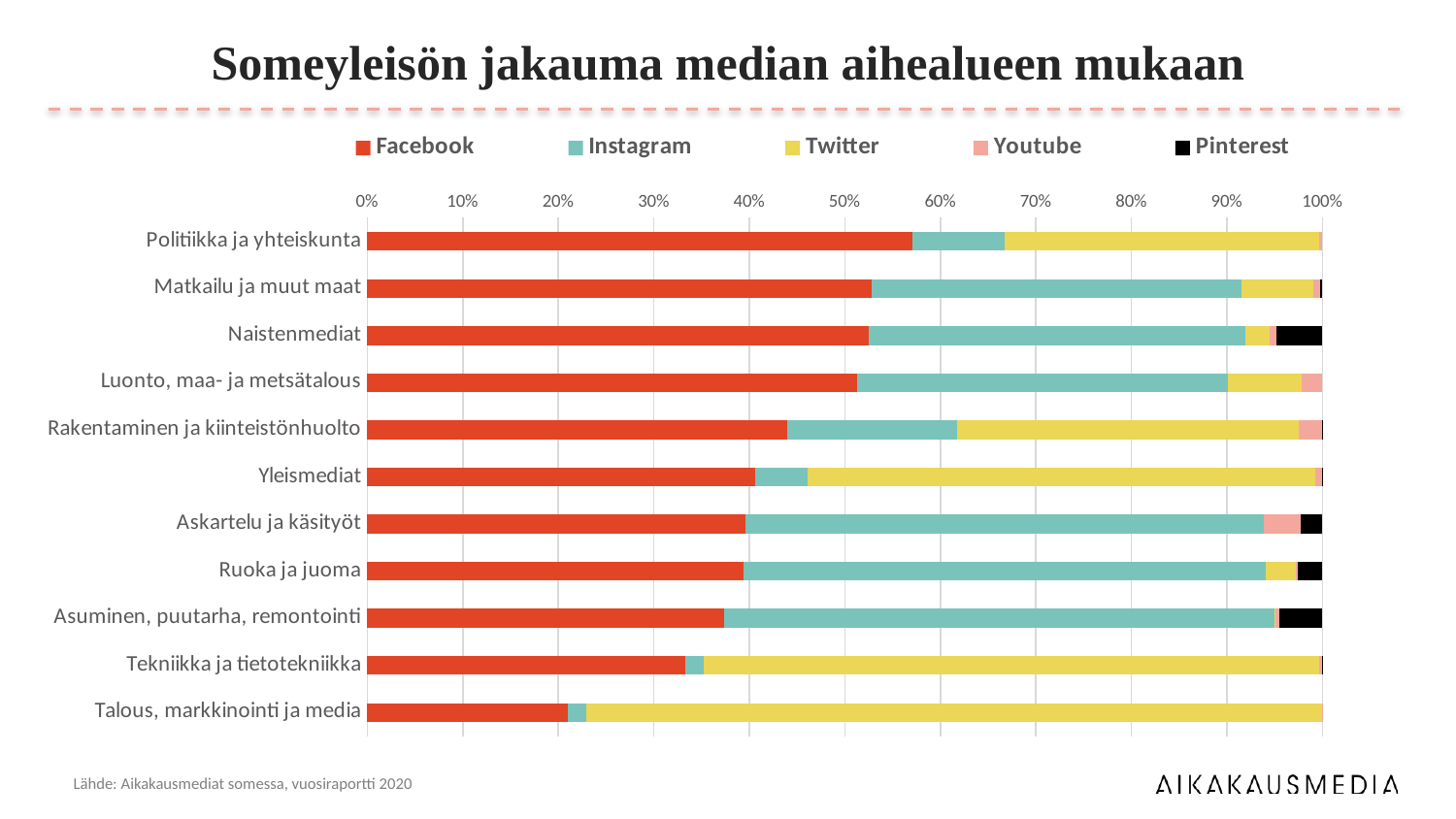
How many series does the legend list? 5 Is the Facebook share for Talous, markkinointi ja media greater or less than 30%? less What is the title of the chart? Someyleisön jakauma median aihealueen mukaan What kind of chart is shown on the slide? Stacked bar chart How many media topic categories are listed on the vertical axis? 11 Which category has the largest Facebook share? Politiikka ja yhteiskunta Which category has the smallest Facebook share? Talous, markkinointi ja media Does the Facebook share rise or fall going from the top category to the bottom category? Fall Is the Facebook share for Tekniikka ja tietotekniikka greater or less than 40%? less Which category has the largest Twitter share? Talous, markkinointi ja media Is the Facebook share for Politiikka ja yhteiskunta greater or less than 50%? greater Which has a larger Facebook share, Yleismediat or Tekniikka ja tietotekniikka? Yleismediat